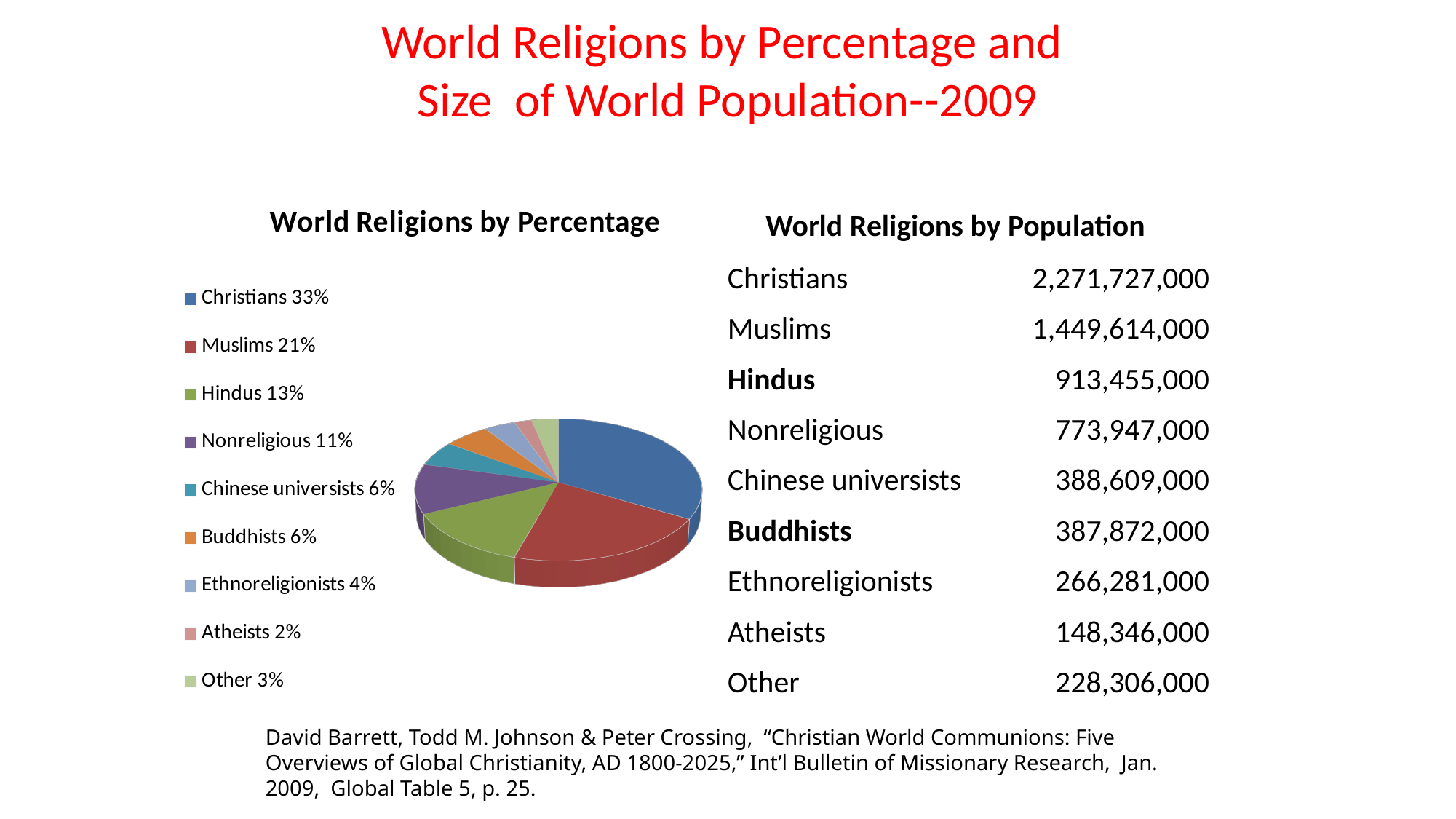
In the pie chart, which is larger, the slice for Hindus or the slice for Nonreligious? Hindus What is the title of the pie chart? World Religions by Percentage In the pie chart, what percentage is shown for Muslims? 21% In the pie chart, what percentage is shown for Christians? 33% How many categories does the pie chart's legend list? 9 In the pie chart, what percentage is shown for Ethnoreligionists? 4% Which category has the smallest slice in the pie chart? Atheists What colour is the Christians slice in the pie chart? blue In the pie chart, what is the difference in percentage points between Christians and Muslims? 12 In the pie chart, what percentage is shown for Nonreligious? 11% Which category has the largest slice in the pie chart? Christians What kind of chart is shown under the title "World Religions by Percentage"? pie chart